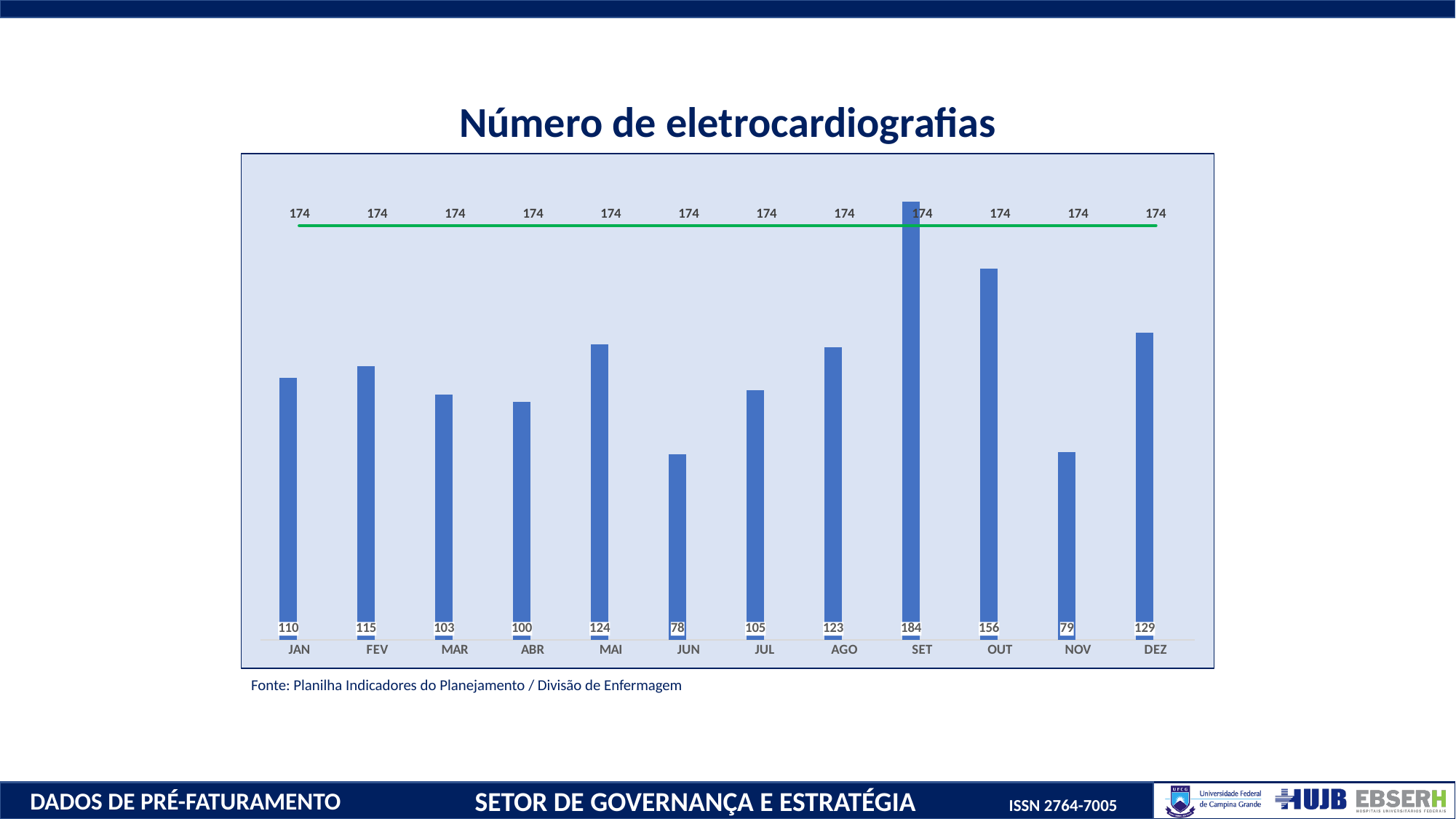
What is the value of the green line for MAR? 174 What is the number of eletrocardiografias for JUN? 78 How many months are shown on the x axis? 12 What is the title of the chart? Número de eletrocardiografias Which is larger, the value for MAI or the value for AGO? MAI What is the number of eletrocardiografias for SET? 184 Which month has the highest number of eletrocardiografias? SET What kind of chart is shown on the slide? combination bar and line chart What is the difference between the values for SET and OUT? 28 Which month has the lowest number of eletrocardiografias? JUN Which is larger, the value for JAN or the value for FEV? FEV What is the difference between the value for DEZ and the green line value for DEZ? 45